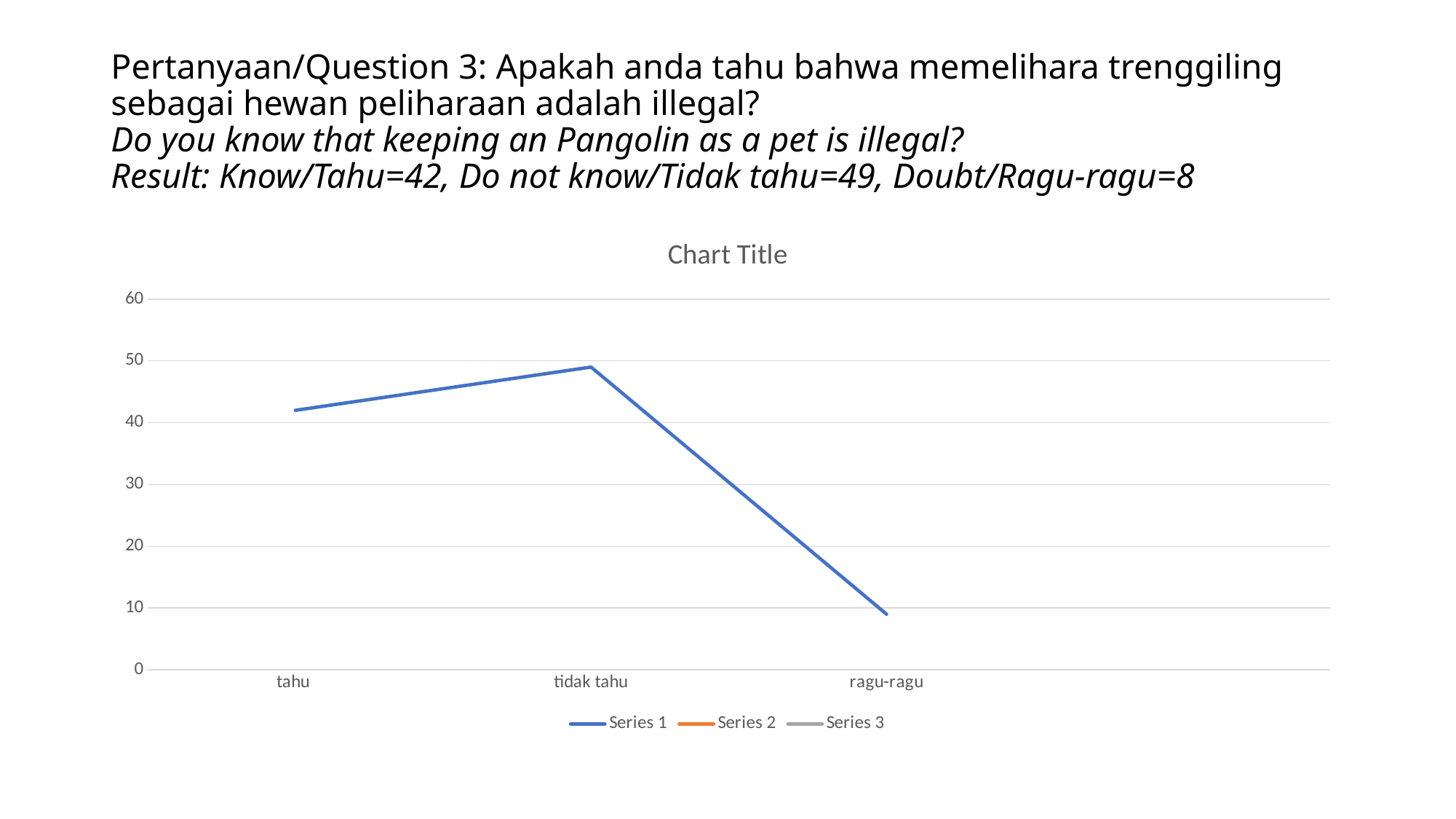
According to the slide, what is the value for tahu (Know)? 42 How many categories are shown on the x axis of the chart? 3 Is the value for ragu-ragu greater or less than 10? less What kind of chart is shown on the slide? line chart Which is larger, the value for tahu or the value for ragu-ragu? tahu How many series does the chart legend list? 3 Which category has the highest value in the chart? tidak tahu What is the title shown above the chart? Chart Title Is the value for tahu greater or less than 50? less According to the slide, what is the value for tidak tahu (Do not know)? 49 Is the value for tidak tahu greater or less than 40? greater Which category has the lowest value in the chart? ragu-ragu